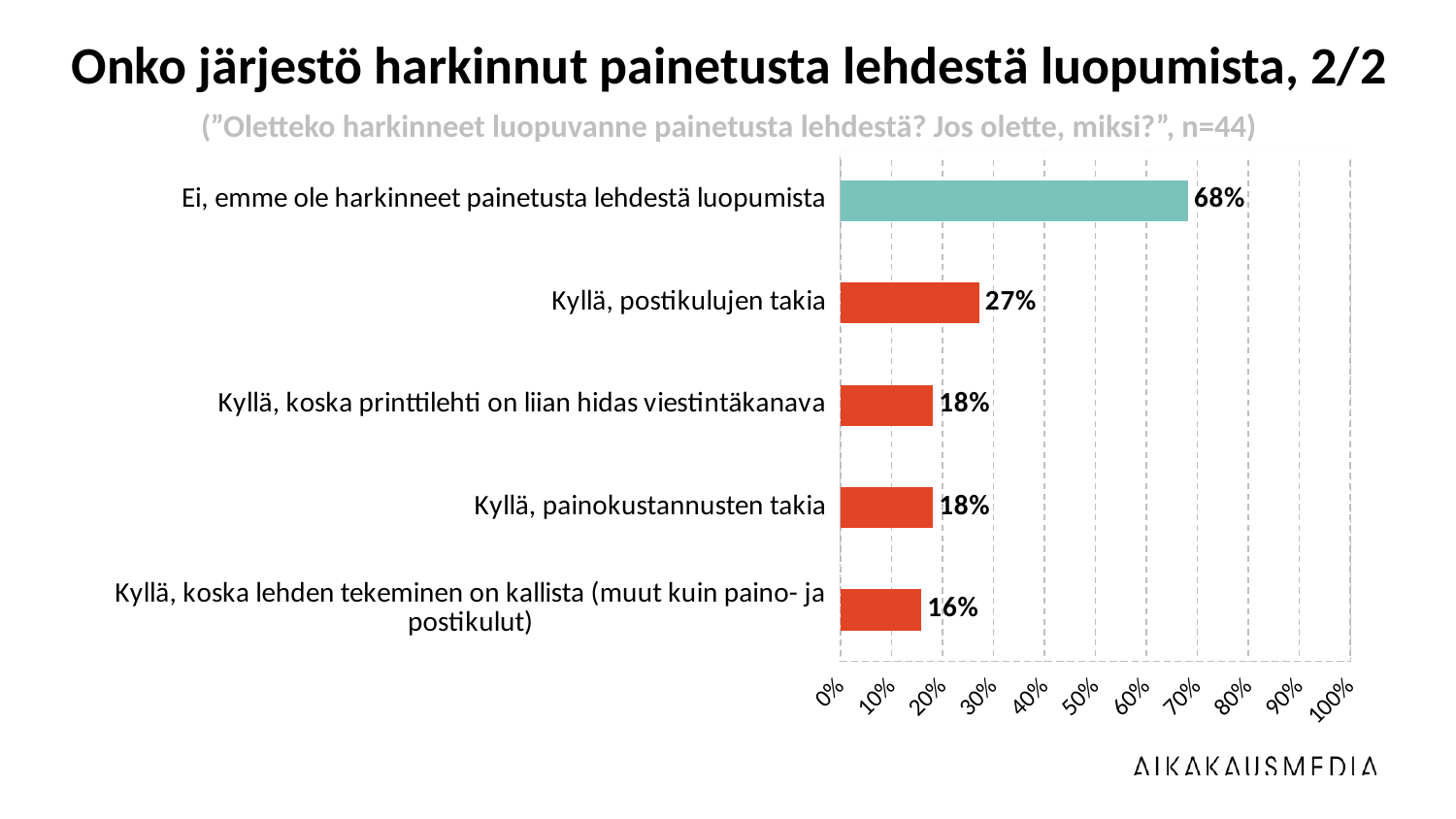
What is the value for "Ei, emme ole harkinneet painetusta lehdestä luopumista"? 68% What is the sample size (n) stated in the chart subtitle? n=44 What is the value for "Kyllä, painokustannusten takia"? 18% Which category has the lowest value? Kyllä, koska lehden tekeminen on kallista (muut kuin paino- ja postikulut) Which is larger: the value for "Kyllä, postikulujen takia" or for "Kyllä, painokustannusten takia"? Kyllä, postikulujen takia What is the value for "Kyllä, koska lehden tekeminen on kallista (muut kuin paino- ja postikulut)"? 16% What is the difference between the values for "Ei, emme ole harkinneet painetusta lehdestä luopumista" and "Kyllä, postikulujen takia"? 41% What is the value for "Kyllä, postikulujen takia"? 27% Is the value for "Kyllä, postikulujen takia" greater or less than 20%? greater What kind of chart is shown on the slide? Bar chart How many categories are shown in the chart? 5 Which category has the highest value? Ei, emme ole harkinneet painetusta lehdestä luopumista